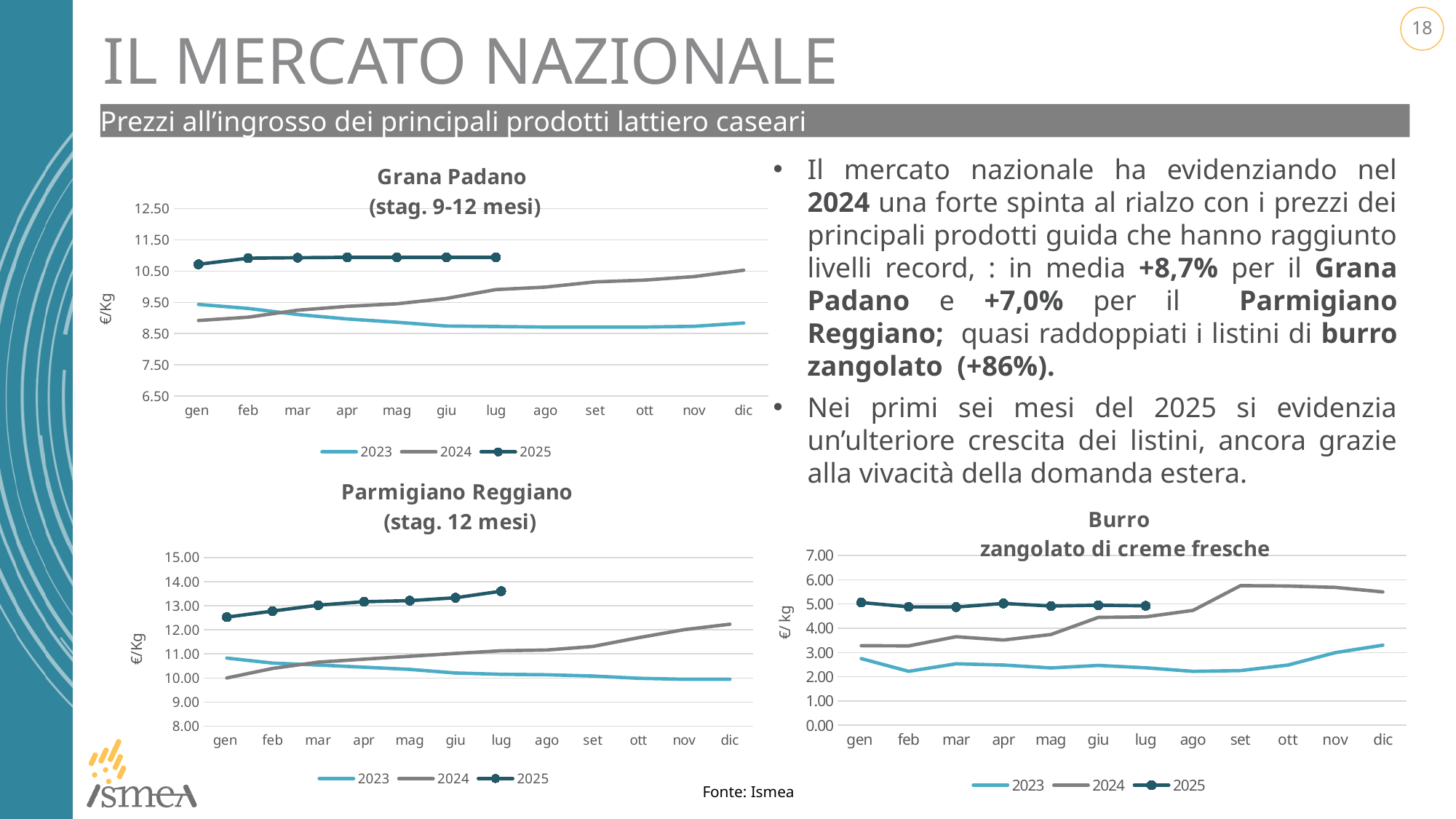
In the Grana Padano chart, does the 2024 line rise or fall from gen to dic? rises In the Burro zangolato di creme fresche chart, which series has the larger value in gen, 2023 or 2025? 2025 How many series does the legend of the Grana Padano chart list? 3 How many data points does the 2025 series have in the Burro zangolato di creme fresche chart? 7 In the Parmigiano Reggiano chart, does the 2025 line rise or fall from gen to lug? rises In the Grana Padano chart, is the 2025 value for gen greater or less than 9.50? greater In the Burro zangolato di creme fresche chart, is the 2024 value for set greater or less than 5.00? greater How many months are shown on the x axis of the Parmigiano Reggiano chart? 12 In the Parmigiano Reggiano chart, is the 2023 value for dic greater or less than 11.00? less In the Grana Padano chart, which series has the larger value in dic, 2023 or 2024? 2024 What kind of chart is the Grana Padano (stag. 9-12 mesi) chart? line chart